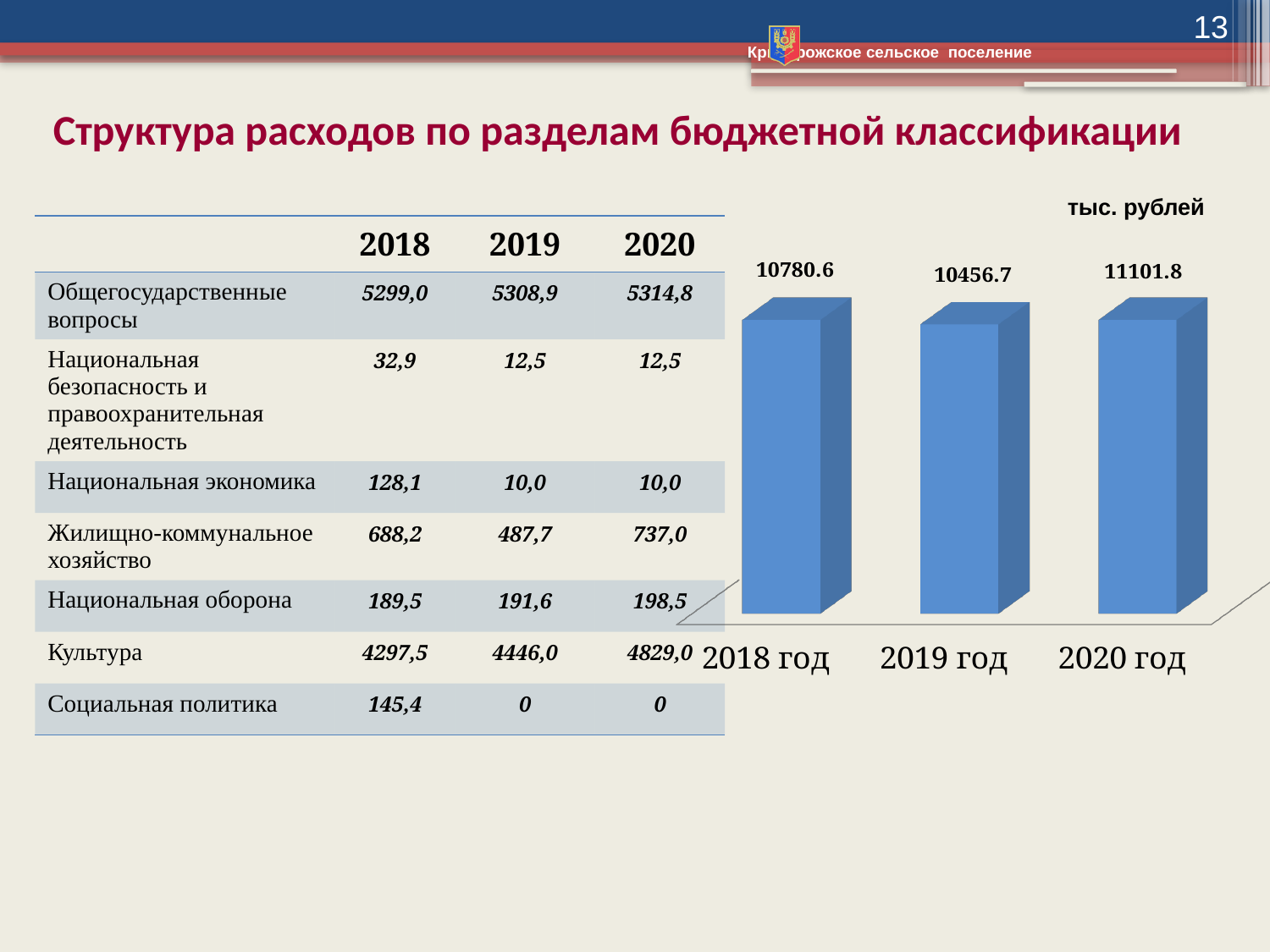
What is the value shown for 2019 год on the bar chart? 10456.7 What is the difference between the values for 2020 год and 2018 год on the bar chart? 321.2 Does the value on the bar chart rise or fall from 2019 год to 2020 год? rise What is the difference between the values for 2018 год and 2019 год on the bar chart? 323.9 Which year has the lowest value on the bar chart? 2019 год How many bars are shown on the chart? 3 Which year has the highest value on the bar chart? 2020 год What kind of chart is shown on the slide? bar chart What is the value shown for 2018 год on the bar chart? 10780.6 What is the value shown for 2020 год on the bar chart? 11101.8 Which is larger on the bar chart, the value for 2018 год or the value for 2019 год? 2018 год What is the difference between the values for 2020 год and 2019 год on the bar chart? 645.1